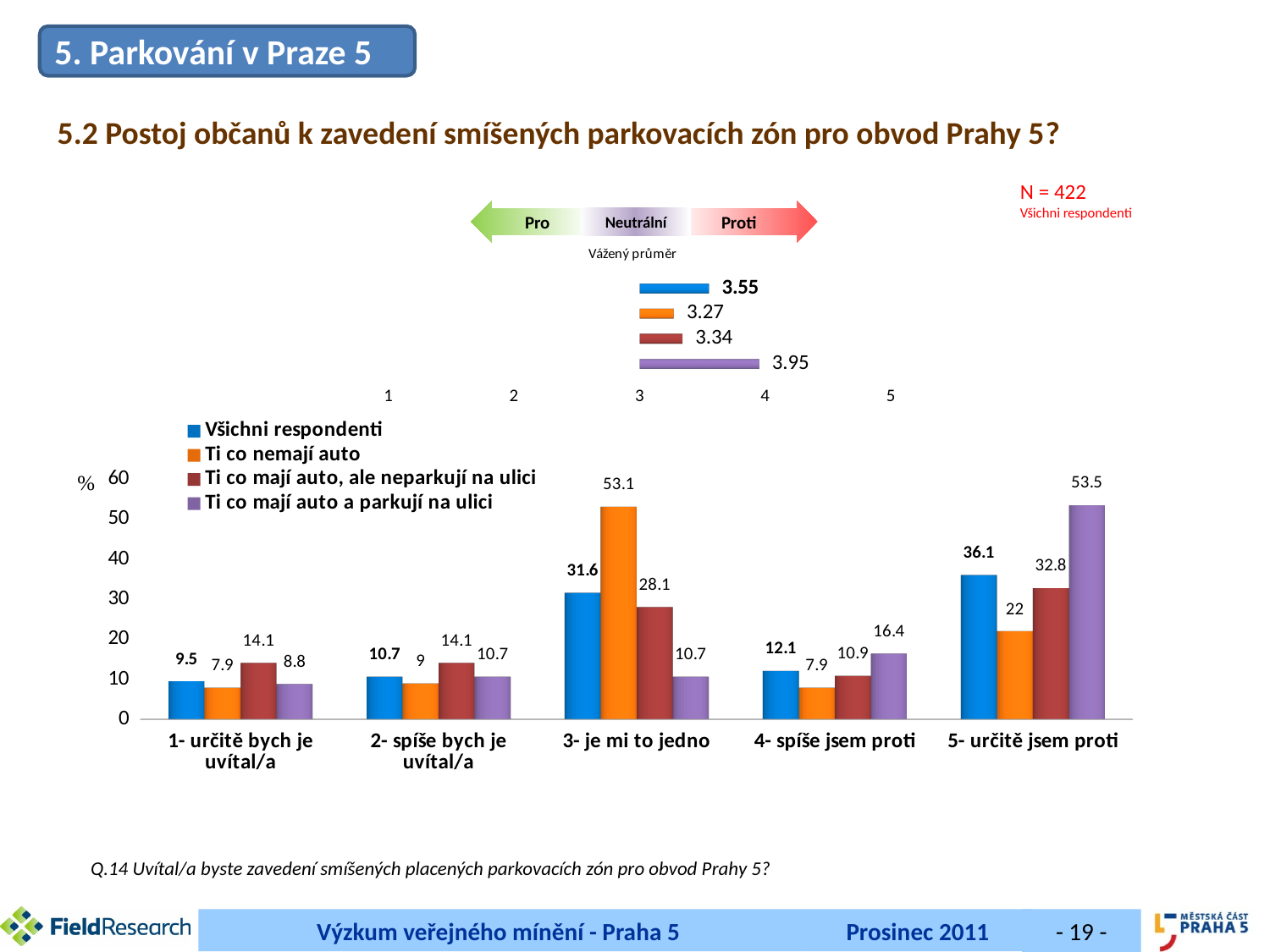
In the lower bar chart, in the category '5- určitě jsem proti', which is larger: 'Ti co nemají auto' or 'Ti co mají auto, ale neparkují na ulici'? Ti co mají auto, ale neparkují na ulici In the lower bar chart, what is the value for 'Ti co mají auto a parkují na ulici' in the category '4- spíše jsem proti'? 16.4 In the lower bar chart, what is the difference between 'Ti co nemají auto' and 'Ti co mají auto a parkují na ulici' in the category '3- je mi to jedno'? 42.4 How many categories are shown on the x axis of the lower bar chart? 5 In the lower bar chart, what is the value for 'Všichni respondenti' in the category '5- určitě jsem proti'? 36.1 In the 'Vážený průměr' chart, which group has the lowest weighted average? Ti co nemají auto In the lower bar chart, what is the value for 'Ti co nemají auto' in the category '3- je mi to jedno'? 53.1 In the 'Vážený průměr' chart, what is the weighted average for 'Ti co mají auto a parkují na ulici' (the purple bar)? 3.95 What kind of chart is the lower chart on the slide? bar chart How many series does the legend of the lower bar chart list? 4 In the lower bar chart, which category has the highest value for 'Ti co mají auto a parkují na ulici'? 5- určitě jsem proti